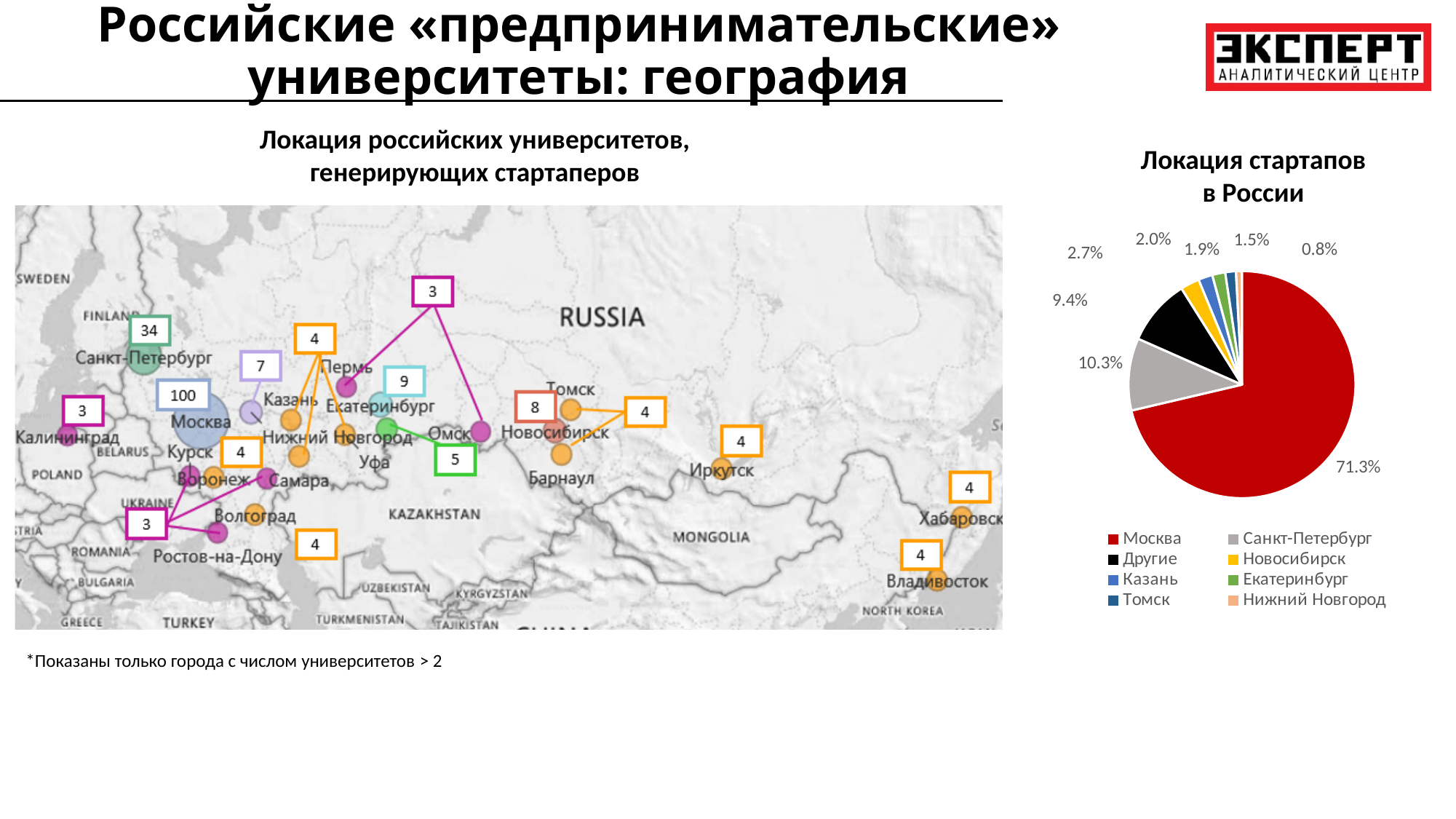
In the chart 'Локация стартапов в России', which category has the largest share? Москва In the chart 'Локация стартапов в России', what share is shown for Нижний Новгород? 0.8% In the chart 'Локация стартапов в России', what share of startups is located in Москва? 71.3% On the map 'Локация российских университетов, генерирующих стартаперов', how many universities are shown for Санкт-Петербург? 34 In the chart 'Локация стартапов в России', which has a larger share, Казань or Томск? Казань In the chart 'Локация стартапов в России', what is the difference between the shares of Санкт-Петербург and Другие? 0.9% How many entries does the legend of the chart 'Локация стартапов в России' list? 8 On the map 'Локация российских университетов, генерирующих стартаперов', how many universities are shown for Москва? 100 In the chart 'Локация стартапов в России', what share is shown for Новосибирск? 2.7% What type of chart is 'Локация стартапов в России'? Pie chart In the chart 'Локация стартапов в России', which city has the smallest share? Нижний Новгород